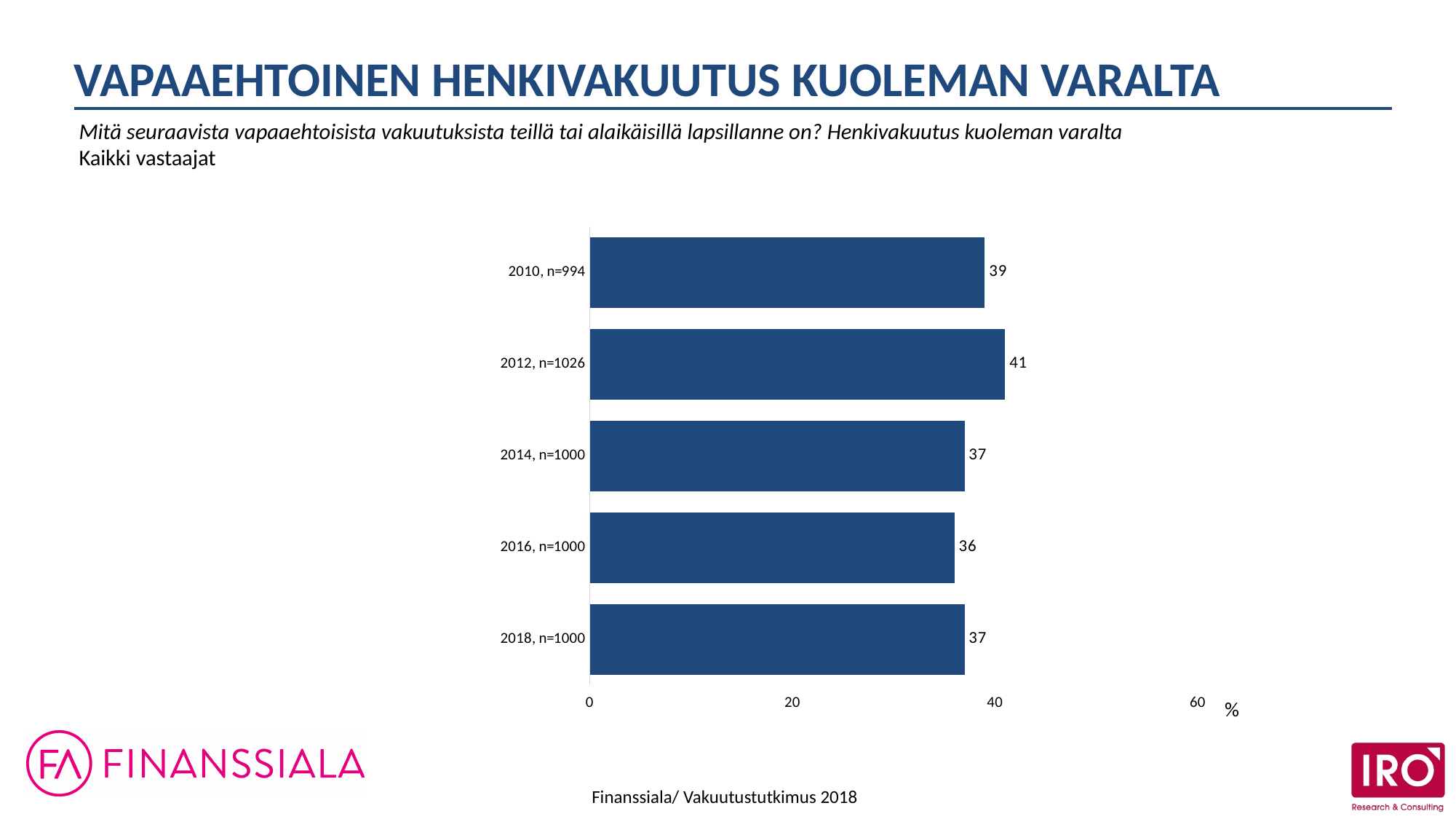
How many categories are shown in the chart? 5 Which category has the lowest value? 2016, n=1000 What is the value for 2010, n=994? 39 What is the difference between the values for 2012, n=1026 and 2016, n=1000? 5 What is the value for 2012, n=1026? 41 Which category has the highest value? 2012, n=1026 What is the value for 2016, n=1000? 36 Is the value for 2012, n=1026 greater or less than 40? greater Which is larger, the value for 2010, n=994 or the value for 2014, n=1000? 2010, n=994 What is the highest tick value shown on the horizontal axis? 60 What is the value for 2018, n=1000? 37 What kind of chart is shown on the slide? bar chart